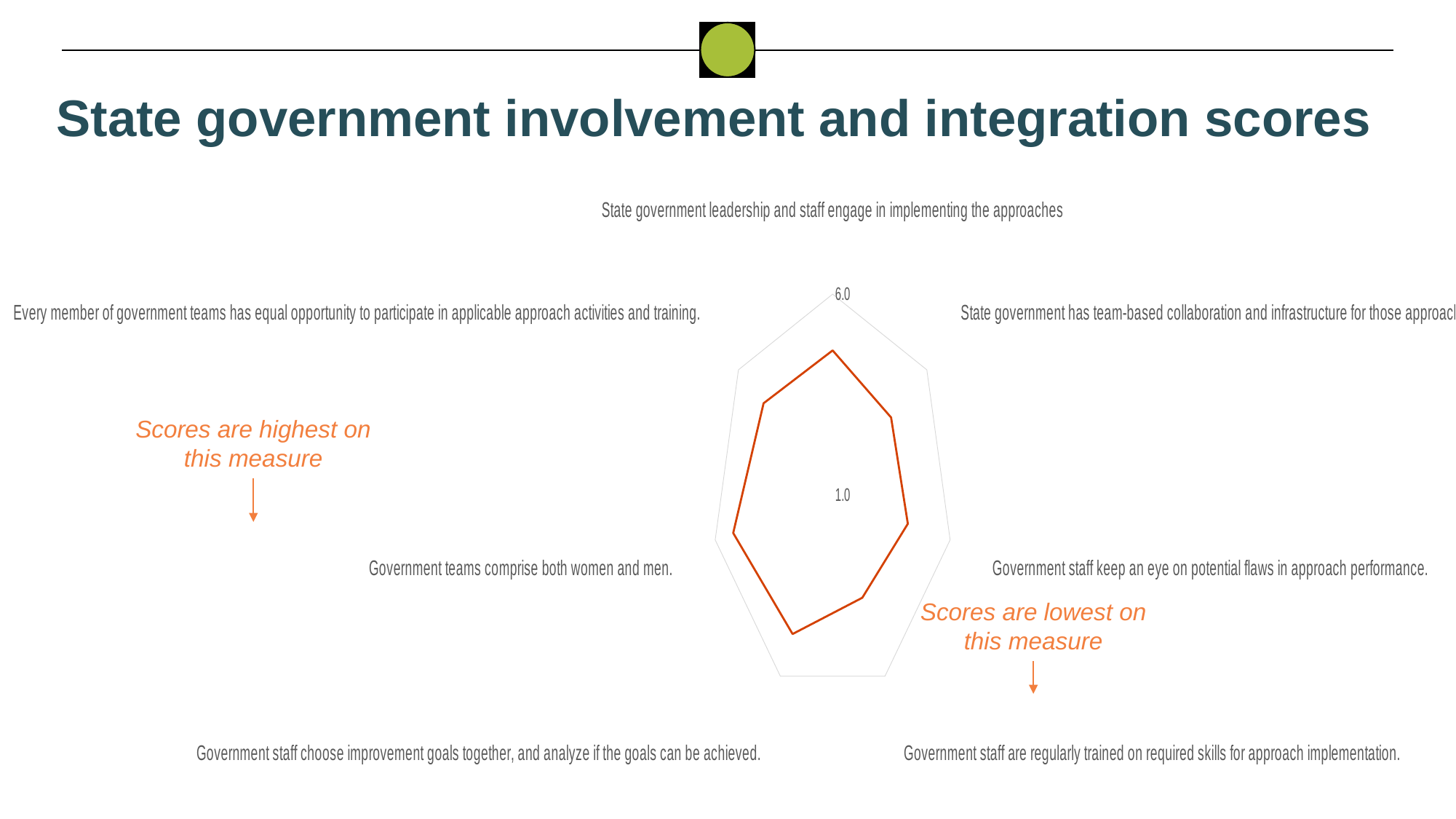
On which measure are the scores lowest, according to the chart annotation? Government staff are regularly trained on required skills for approach implementation. How many measures (axes) does the radar chart plot? 7 What kind of chart is shown on the slide? Radar chart Is the score for 'Government teams comprise both women and men' greater or less than 1.0? greater Which has the larger score: 'Government teams comprise both women and men' or 'Government staff are regularly trained on required skills for approach implementation'? Government teams comprise both women and men. What is the title of the slide containing the radar chart? State government involvement and integration scores What are the minimum and maximum values labelled on the radar chart's scale? 1.0 and 6.0 Is the score for 'Government staff are regularly trained on required skills for approach implementation' greater or less than 6.0? less On which measure are the scores highest, according to the chart annotation? Government teams comprise both women and men.